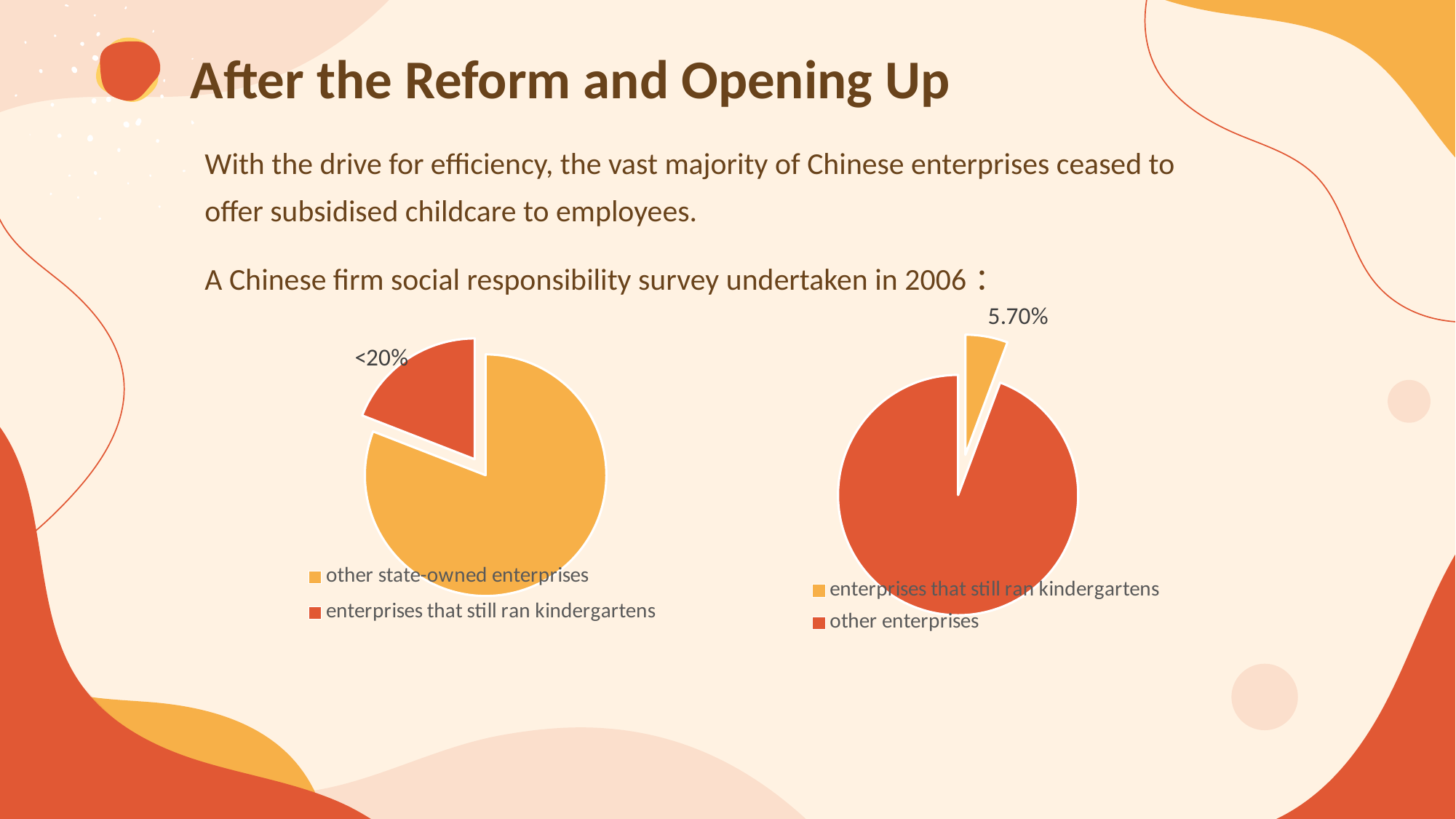
What type of chart is the chart on the left of the slide? pie chart In the right-hand pie chart, which category has the largest slice? other enterprises How many categories does the legend of the left-hand pie chart list? 2 In the right-hand pie chart, is the slice for other enterprises larger or smaller than the slice for enterprises that still ran kindergartens? larger In the right-hand pie chart, what colour is the slice for enterprises that still ran kindergartens? orange In the right-hand pie chart, which category has the smallest slice? enterprises that still ran kindergartens What type of chart is the chart on the right of the slide? pie chart How many slices does the right-hand pie chart have? 2 In the left-hand pie chart, what label is printed on the slice for enterprises that still ran kindergartens? <20% In the left-hand pie chart, which category has the smallest slice? enterprises that still ran kindergartens In the left-hand pie chart, which category has the largest slice? other state-owned enterprises In the right-hand pie chart, what percentage is shown for enterprises that still ran kindergartens? 5.70%